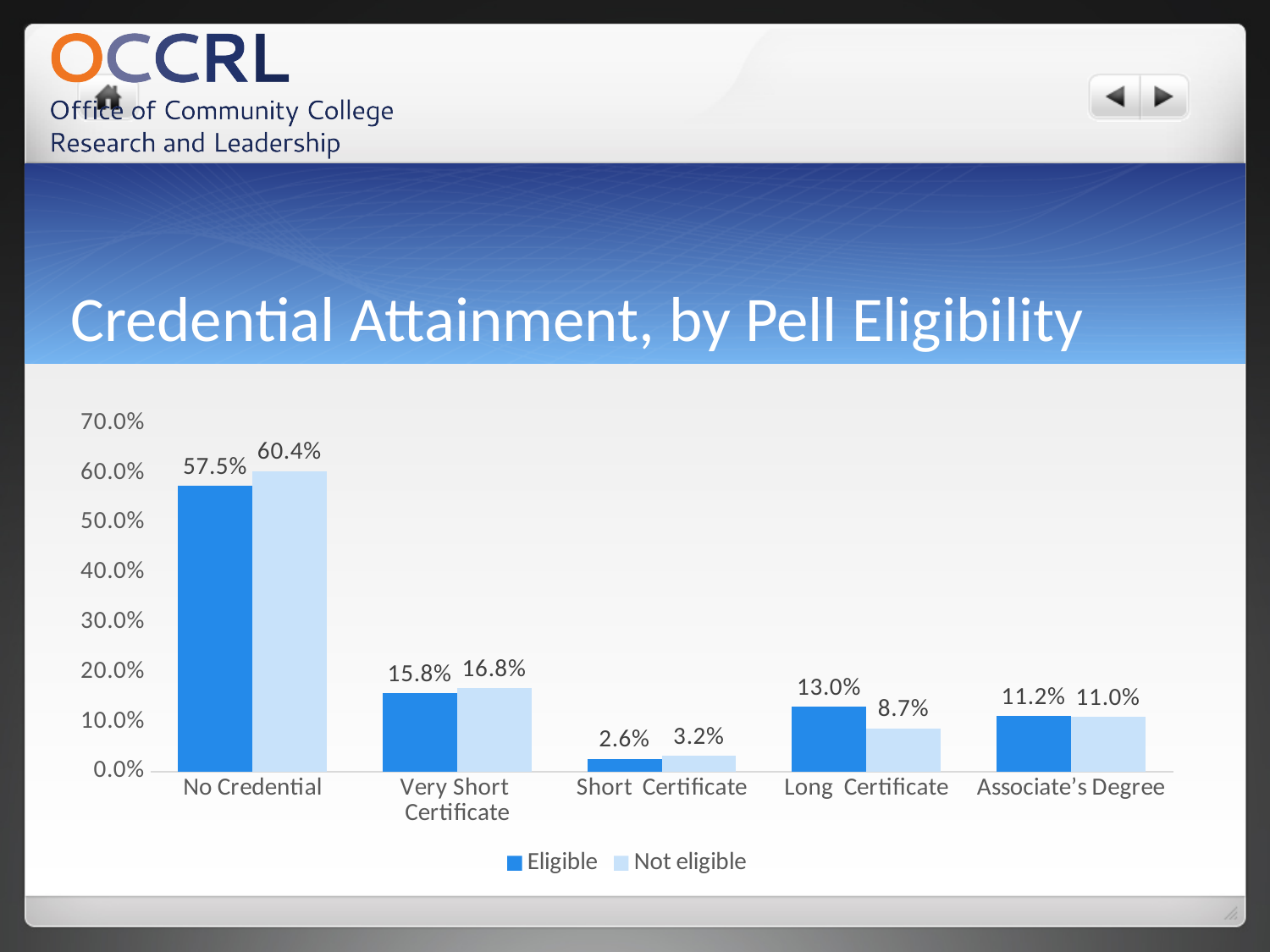
What type of chart is shown on the slide? Bar chart What is the difference between the Eligible and Not eligible values for Long Certificate? 4.3% Which category has the lowest Eligible value? Short Certificate For Very Short Certificate, which is larger: the Eligible or the Not eligible value? Not eligible How many categories are shown on the x axis? 5 What is the Not eligible value for Long Certificate? 8.7% What is the difference between the Not eligible and Eligible values for No Credential? 2.9% Is the Eligible value for No Credential greater or less than 50.0%? greater Which category has the highest Not eligible value? No Credential What is the Eligible value for No Credential? 57.5% How many series does the legend list? 2 What is the Eligible value for Short Certificate? 2.6%